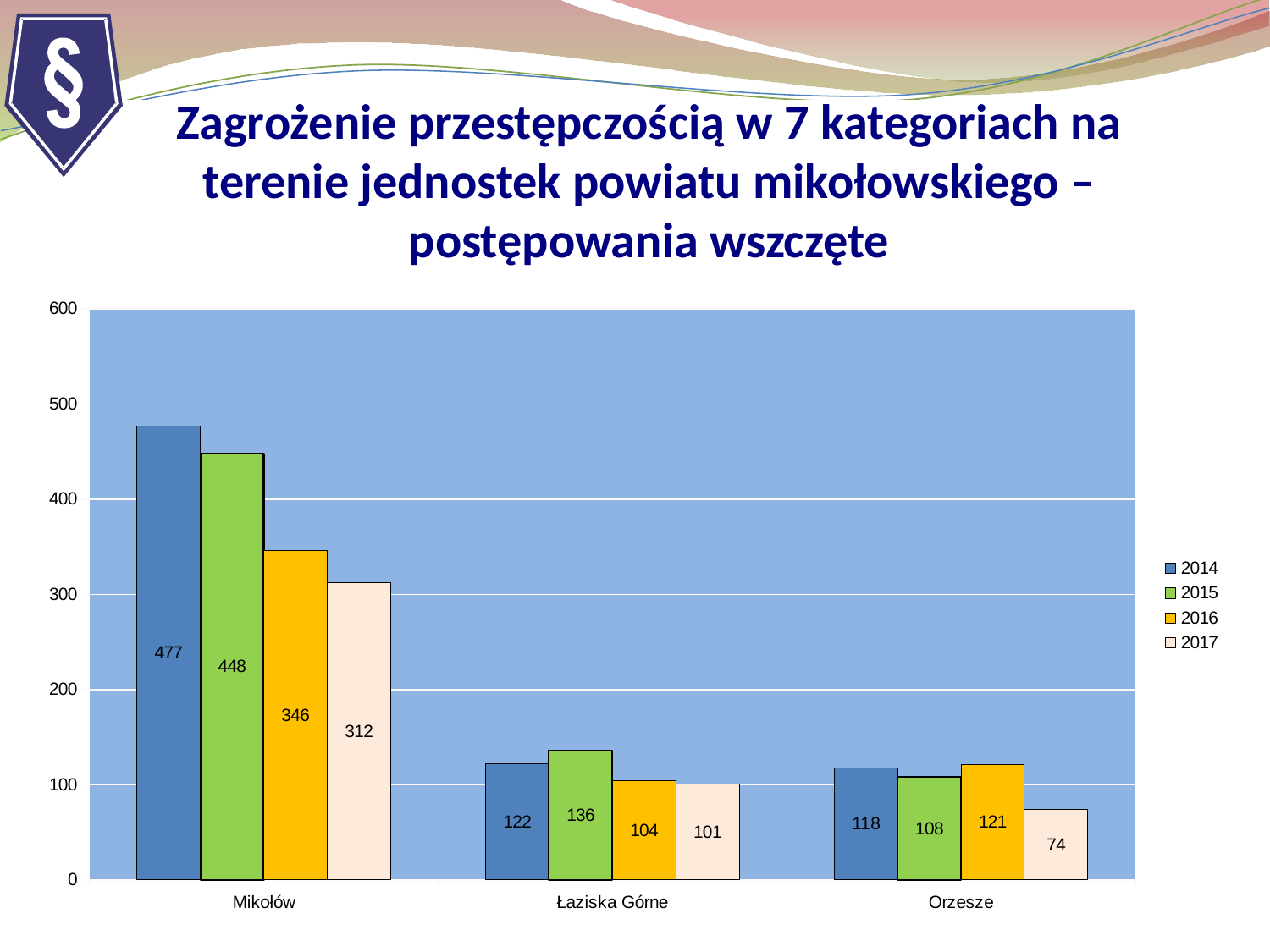
What kind of chart is shown on the slide? bar chart What is the value for Łaziska Górne in 2015? 136 What is the value for Mikołów in 2014? 477 What is the value for Orzesze in 2017? 74 How many series does the legend list? 4 Is the value for Mikołów in 2015 greater or less than 400? greater Do the values for Mikołów rise or fall from 2014 to 2017? fall Which category has the lowest value in 2017? Orzesze Which category has the highest value in 2016? Mikołów How many categories are shown on the x axis? 3 What is the difference between the 2014 and 2017 values for Mikołów? 165 Which is larger: the 2016 value for Łaziska Górne or the 2016 value for Orzesze? Orzesze